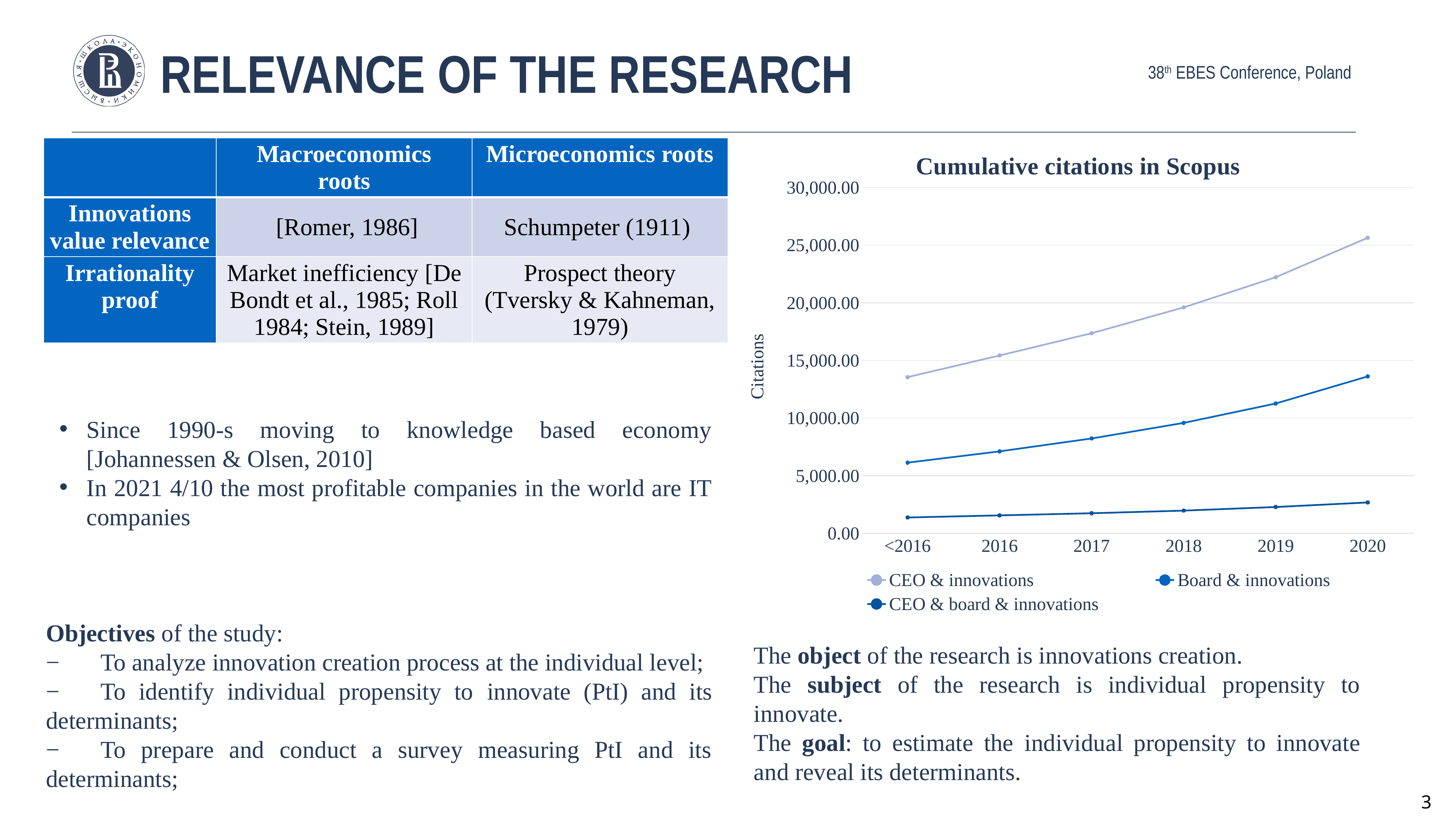
What is the title of the chart on the slide? Cumulative citations in Scopus Which series has the lowest value in 2020? CEO & board & innovations What type of chart is shown on the slide? line chart What is the label of the vertical axis of the chart? Citations Which is larger in 2017: the value for Board & innovations or the value for CEO & board & innovations? Board & innovations How many series does the chart's legend list? 3 Is the value for Board & innovations in 2020 greater or less than 15,000.00? less Do the values for CEO & innovations rise or fall from <2016 to 2020? rise Is the value for CEO & board & innovations in 2020 greater or less than 5,000.00? less Is the value for CEO & innovations in 2020 greater or less than 20,000.00? greater How many points along the x axis does each series in the chart have? 6 Which series has the highest value in 2020? CEO & innovations